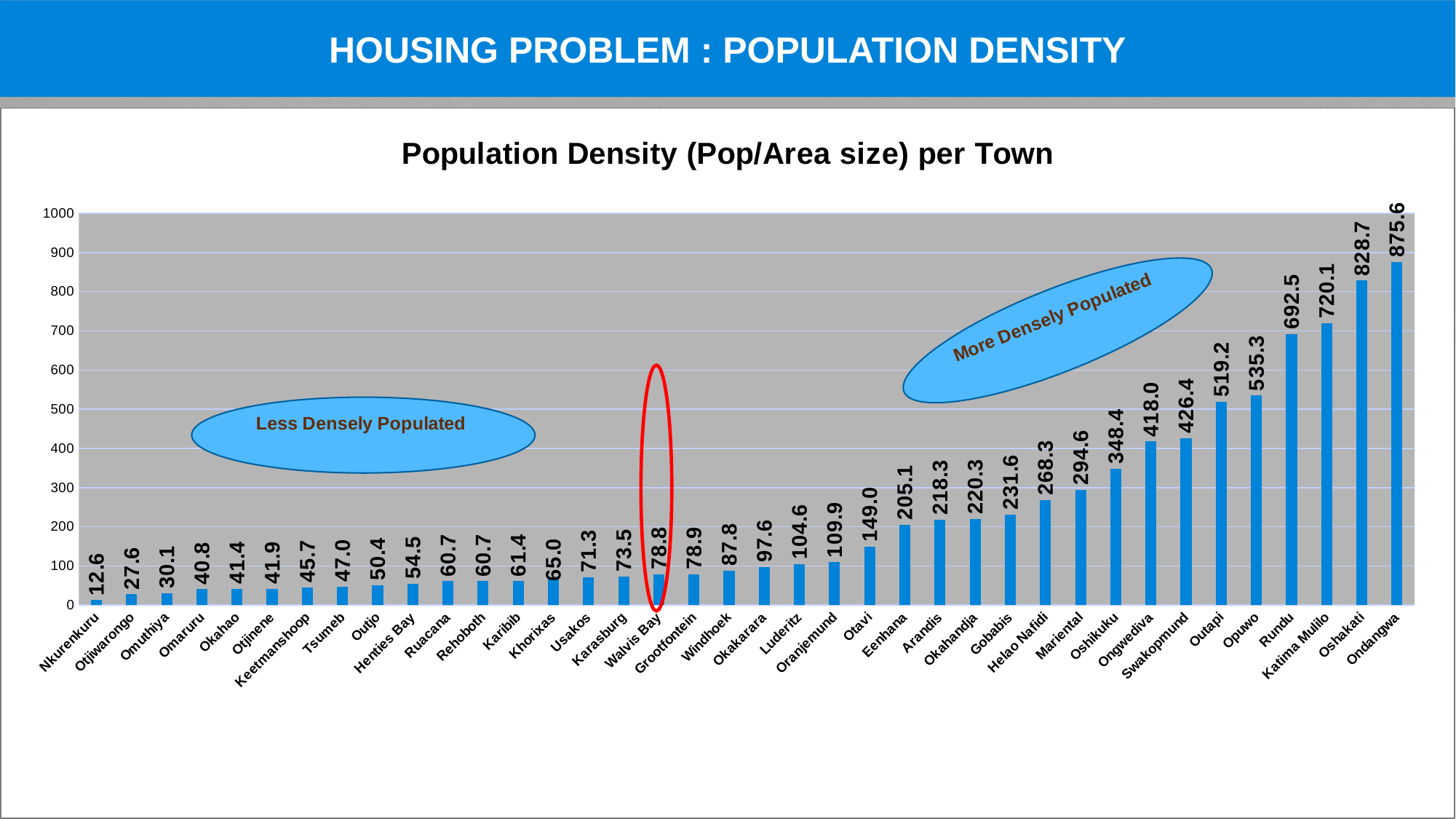
Do the values rise or fall from left to right along the x axis? Rise What is the difference in population density between Ondangwa and Oshakati? 46.9 What is the population density for Windhoek? 87.8 Is the value for Oshikuku greater or less than 300? greater What is the title of the chart? Population Density (Pop/Area size) per Town What is the population density for Swakopmund? 426.4 How many towns are shown on the chart? 38 Which has a higher population density, Rundu or Opuwo? Rundu What kind of chart is shown on the slide? Bar chart What is the population density for Walvis Bay, the town circled in red? 78.8 Which town has the highest population density? Ondangwa Which town has the lowest population density? Nkurenkuru